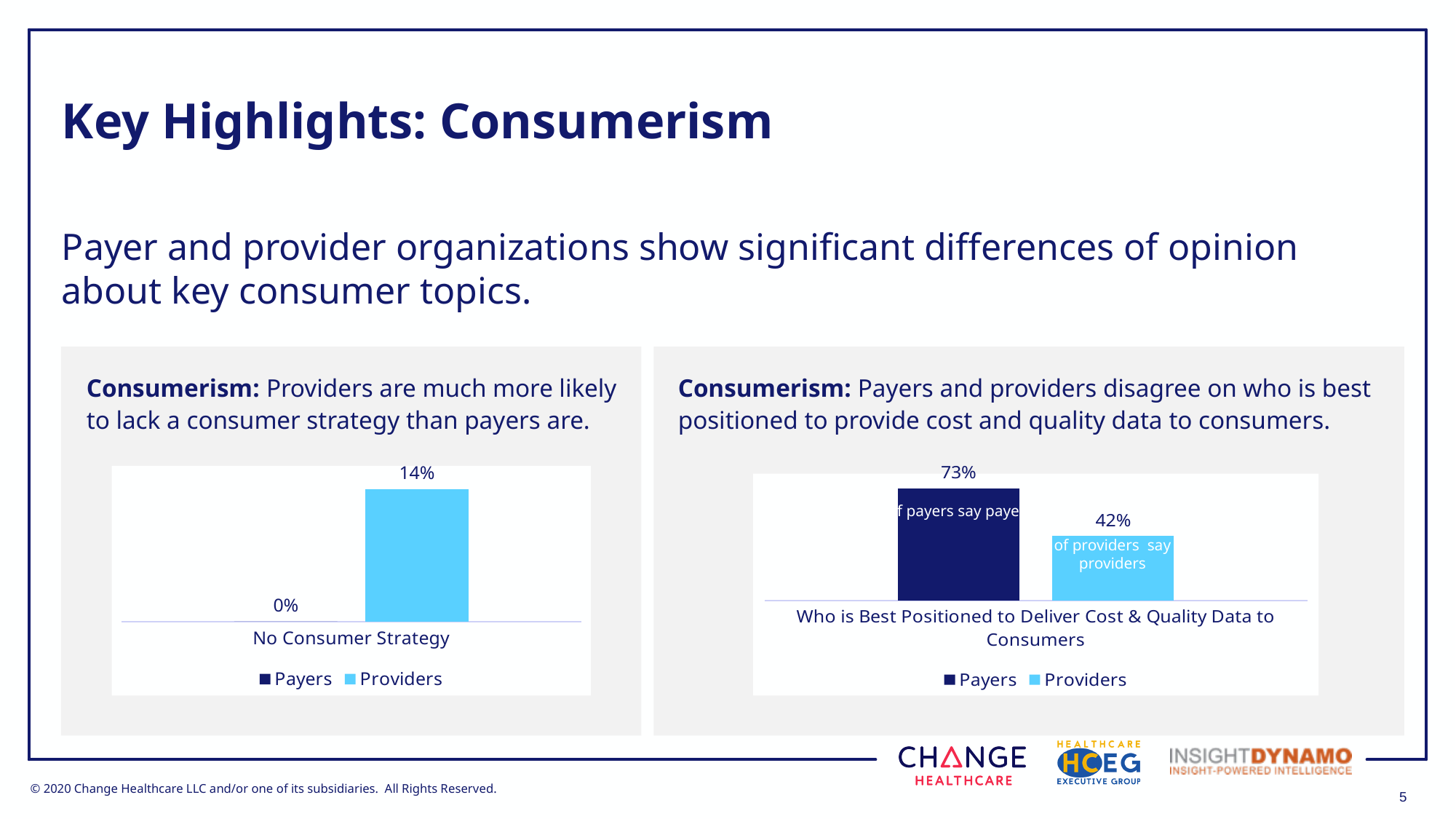
In the left chart (No Consumer Strategy), what is the difference between the Providers and Payers values? 14% In the left chart (No Consumer Strategy), which series has the higher value, Payers or Providers? Providers In the right chart (Who is Best Positioned to Deliver Cost & Quality Data to Consumers), what colour is the Payers bar? Dark navy blue In the right chart (Who is Best Positioned to Deliver Cost & Quality Data to Consumers), what is the difference between the Payers and Providers values? 31% In the left chart (No Consumer Strategy), what is the value for Providers? 14% In the right chart (Who is Best Positioned to Deliver Cost & Quality Data to Consumers), what is the value for Providers? 42% In the left chart (No Consumer Strategy), how many series does the legend list? 2 In the left chart (No Consumer Strategy), what is the value for Payers? 0% In the right chart (Who is Best Positioned to Deliver Cost & Quality Data to Consumers), what is the value for Payers? 73% What is the category label on the x axis of the left chart? No Consumer Strategy In the right chart (Who is Best Positioned to Deliver Cost & Quality Data to Consumers), which series has the higher value? Payers What kind of chart is the right chart (Who is Best Positioned to Deliver Cost & Quality Data to Consumers)? Bar chart